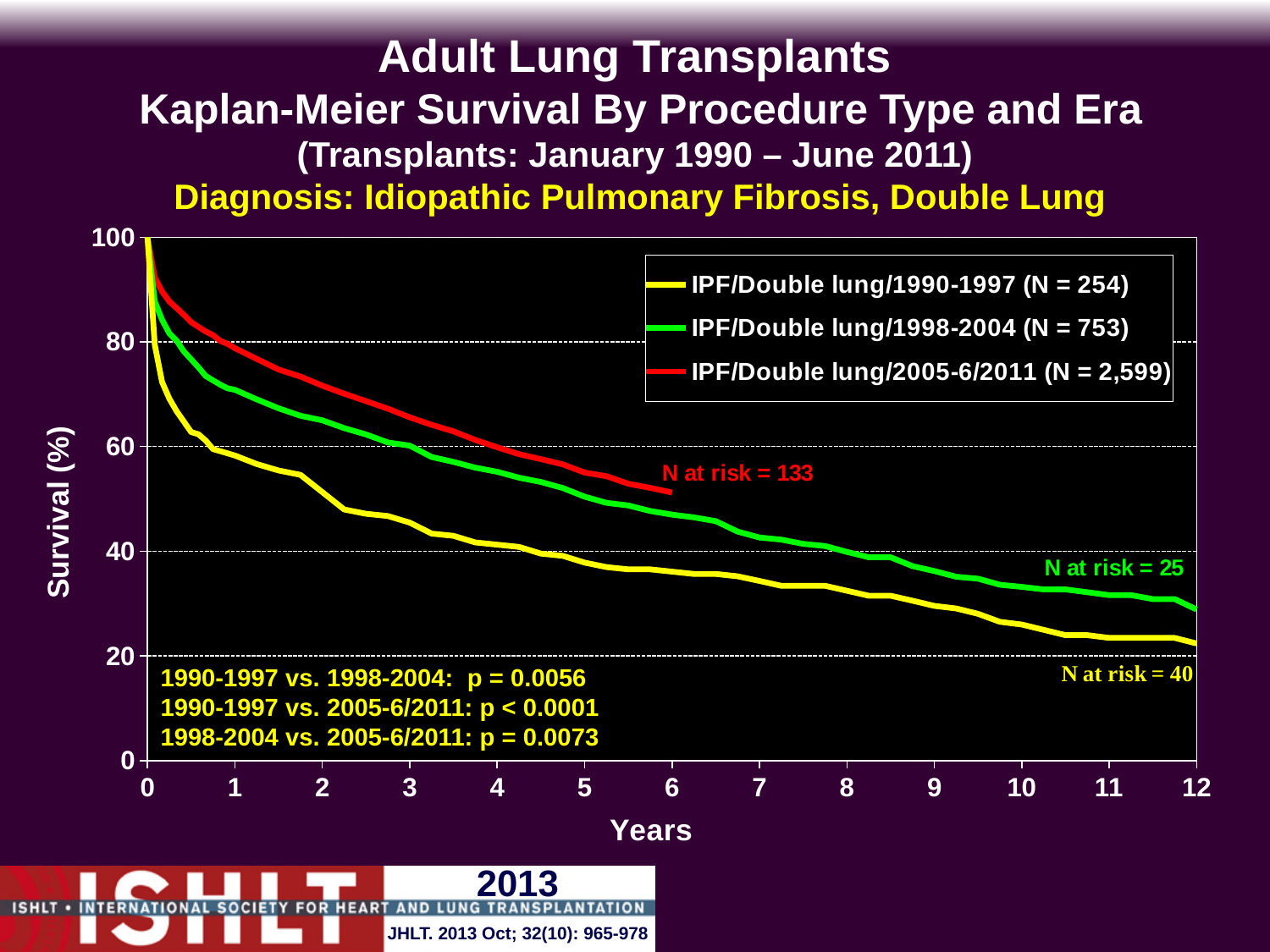
Is the survival value for the 1990-1997 series at 12 years greater or less than 40? less What is the N for the IPF/Double lung/2005-6/2011 series shown in the legend? 2,599 What is the N for the IPF/Double lung/1990-1997 series shown in the legend? 254 What is the N at risk value printed next to the green 1998-2004 curve? 25 What is the N for the IPF/Double lung/1998-2004 series shown in the legend? 753 At 6 years, which series has higher survival: 1998-2004 or 1990-1997? 1998-2004 Do the survival curves rise or fall as years increase? fall What is the N at risk value printed next to the red 2005-6/2011 curve? 133 How many series does the legend list? 3 Which series has the lowest survival at 12 years? IPF/Double lung/1990-1997 What kind of chart is shown on the slide? line chart Is the survival value for the 1998-2004 series at 1 year greater or less than 60? greater